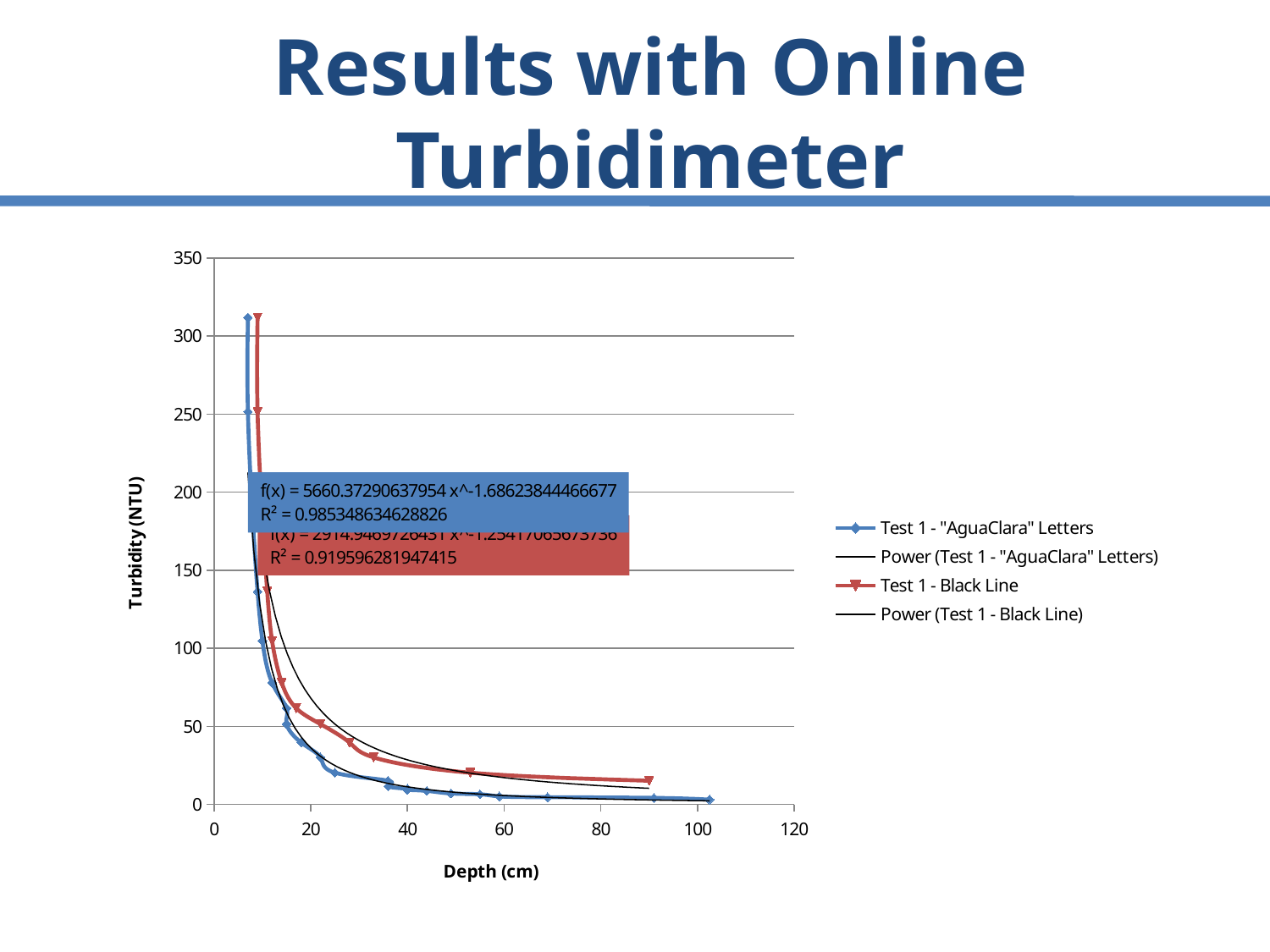
What is the maximum value shown on the y axis? 350 Is the turbidity for Test 1 - "AguaClara" Letters at a depth of about 100 cm greater or less than 50? less What is the R² value shown in the blue box for the "AguaClara" Letters power fit? 0.985348634628826 How many entries does the chart legend list? 4 What kind of chart is shown on the slide? line chart Is the turbidity for Test 1 - Black Line at a depth of about 90 cm greater or less than 50? less What is the R² value shown in the red box for the Black Line power fit? 0.919596281947415 Which series has the higher turbidity at a depth of around 60 cm: Test 1 - "AguaClara" Letters or Test 1 - Black Line? Test 1 - Black Line Is the highest turbidity value for Test 1 - "AguaClara" Letters greater or less than 300? greater What is the title of the x axis? Depth (cm) What is the title of the y axis? Turbidity (NTU) As depth increases along the x axis, does turbidity rise or fall? fall